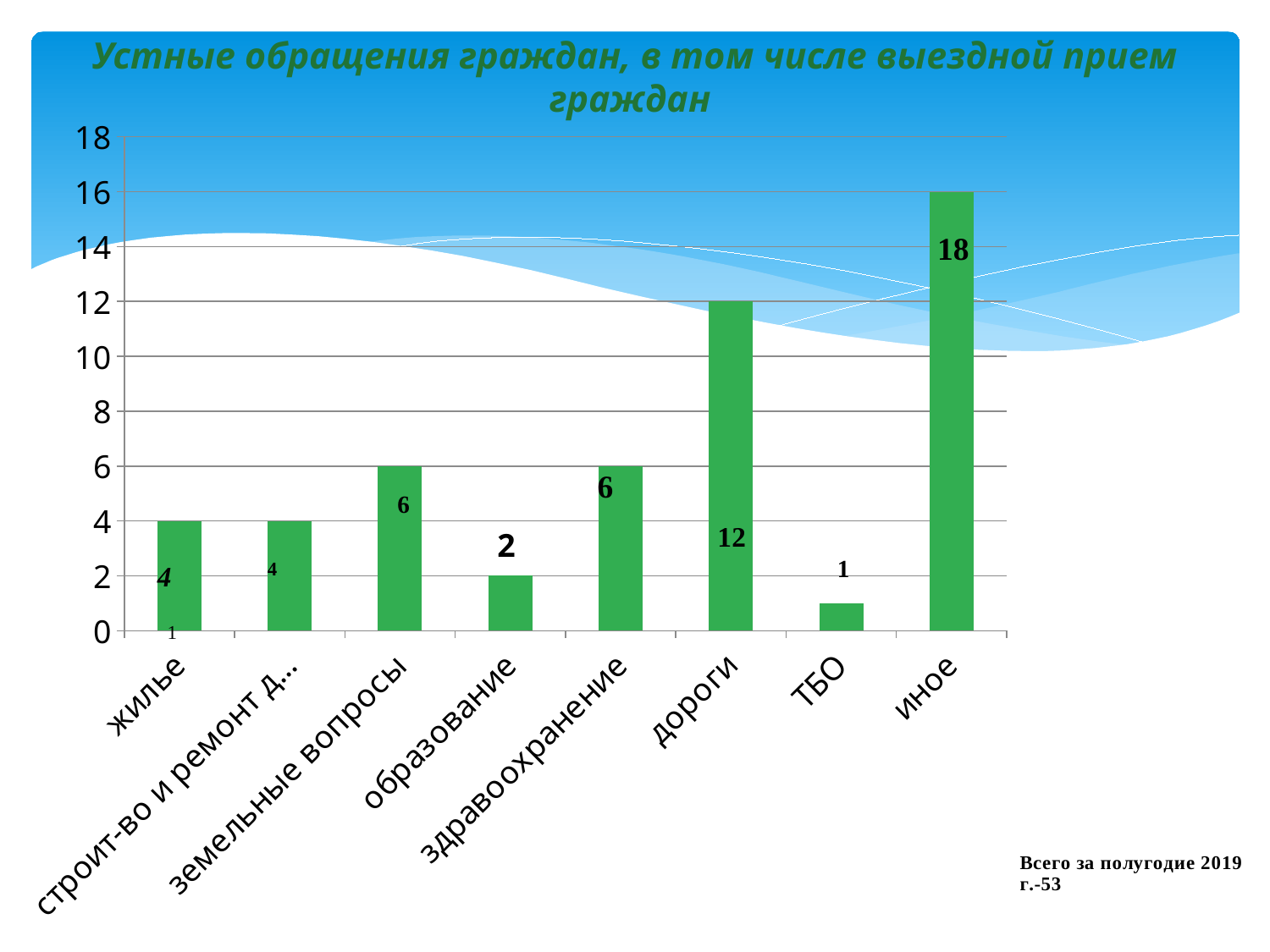
What is the value for дороги? 12 What is the value for ТБО? 1 What is the difference between the values for дороги and здравоохранение? 6 What is the title of the chart? Устные обращения граждан, в том числе выездной прием граждан How many categories are shown on the x axis of the chart? 8 Which category has the highest value? иное What is the value for здравоохранение? 6 What is the value for образование? 2 What type of chart is shown on the slide? bar chart Which category has the lowest value? ТБО What is the value for жилье? 4 Is the value for иное greater or less than 14? greater